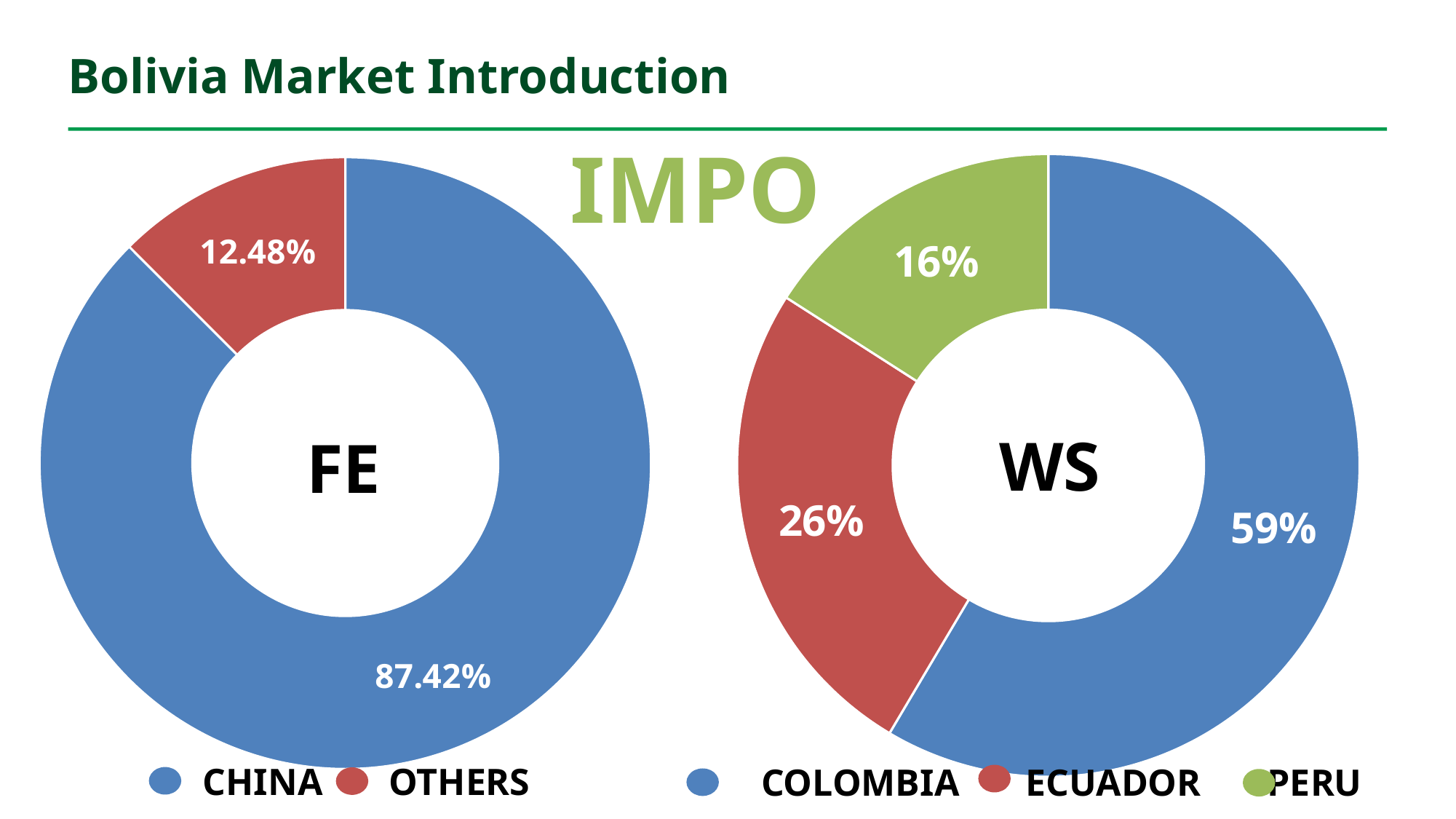
How many categories does the legend of the WS chart list? 3 On the FE chart, which is larger, CHINA or OTHERS? CHINA On the FE chart, what share does CHINA hold? 87.42% On the WS chart, which category has the smallest share? PERU On the FE chart, what share does OTHERS hold? 12.48% What kind of chart is the FE chart? Doughnut chart On the FE chart, what is the difference between the shares of CHINA and OTHERS? 74.94% On the WS chart, what share does PERU hold? 16% On the WS chart, what share does ECUADOR hold? 26% On the WS chart, what is the difference between the shares of COLOMBIA and ECUADOR? 33% On the WS chart, what share does COLOMBIA hold? 59% On the WS chart, which category has the largest share? COLOMBIA